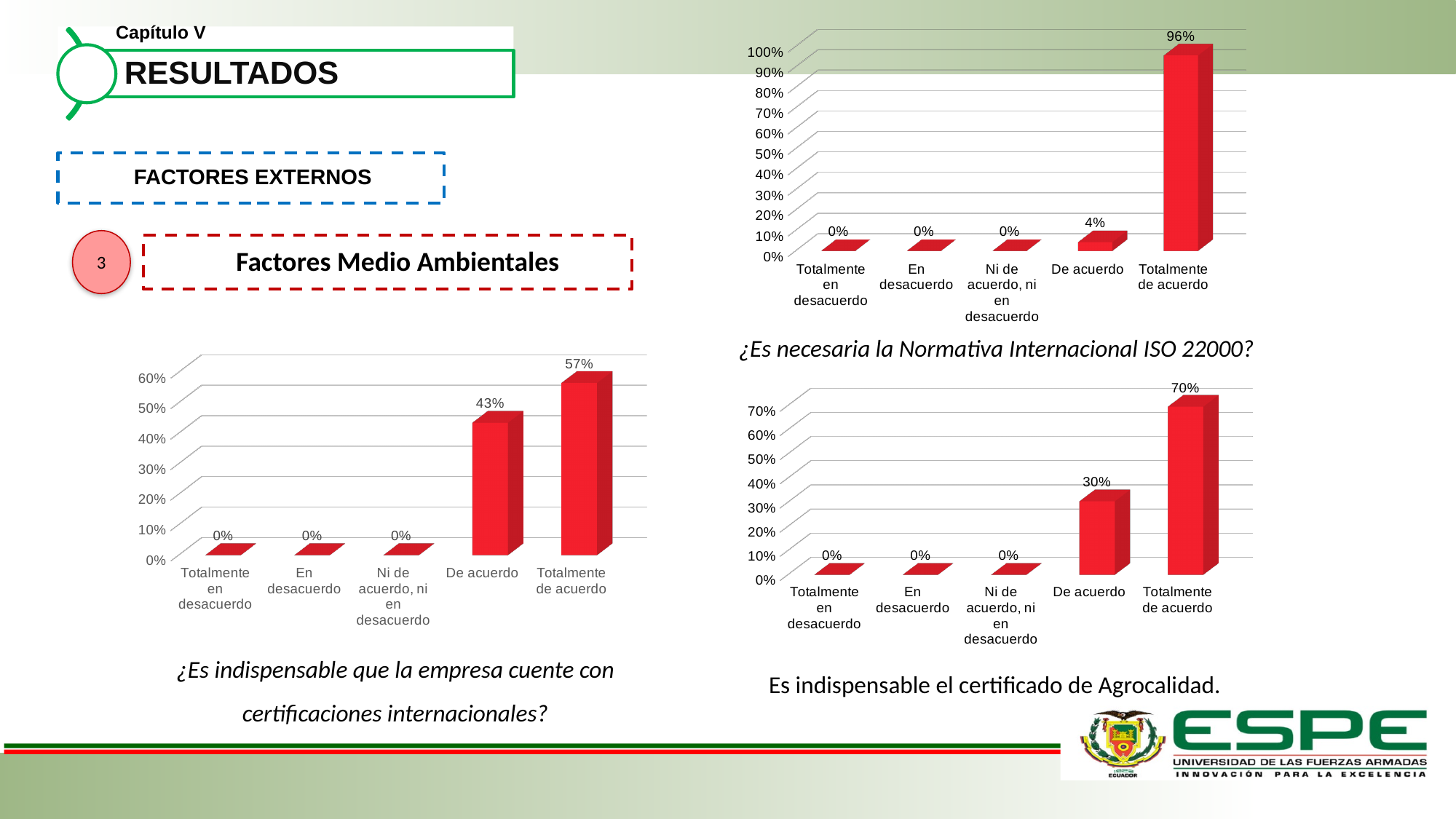
What kind of chart is the top-right chart (¿Es necesaria la Normativa Internacional ISO 22000?)? Bar chart In the top-right chart (¿Es necesaria la Normativa Internacional ISO 22000?), what is the value for 'Totalmente de acuerdo'? 96% In the top-right chart (¿Es necesaria la Normativa Internacional ISO 22000?), what is the value for 'En desacuerdo'? 0% In the top-right chart (¿Es necesaria la Normativa Internacional ISO 22000?), what is the value for 'De acuerdo'? 4% In the bottom-left chart (¿Es indispensable que la empresa cuente con certificaciones internacionales?), what is the value for 'De acuerdo'? 43% In the bottom-left chart (¿Es indispensable que la empresa cuente con certificaciones internacionales?), which category has the highest value? Totalmente de acuerdo In the bottom-right chart (Es indispensable el certificado de Agrocalidad), what is the difference between 'Totalmente de acuerdo' and 'De acuerdo'? 40% In the top-right chart (¿Es necesaria la Normativa Internacional ISO 22000?), which is larger, 'De acuerdo' or 'Totalmente de acuerdo'? Totalmente de acuerdo How many categories are shown on the x axis of the bottom-right chart (Es indispensable el certificado de Agrocalidad)? 5 In the bottom-left chart (¿Es indispensable que la empresa cuente con certificaciones internacionales?), what is the difference between 'Totalmente de acuerdo' and 'De acuerdo'? 14% In the bottom-right chart (Es indispensable el certificado de Agrocalidad), what is the value for 'Totalmente de acuerdo'? 70% In the bottom-right chart (Es indispensable el certificado de Agrocalidad), what is the value for 'De acuerdo'? 30%